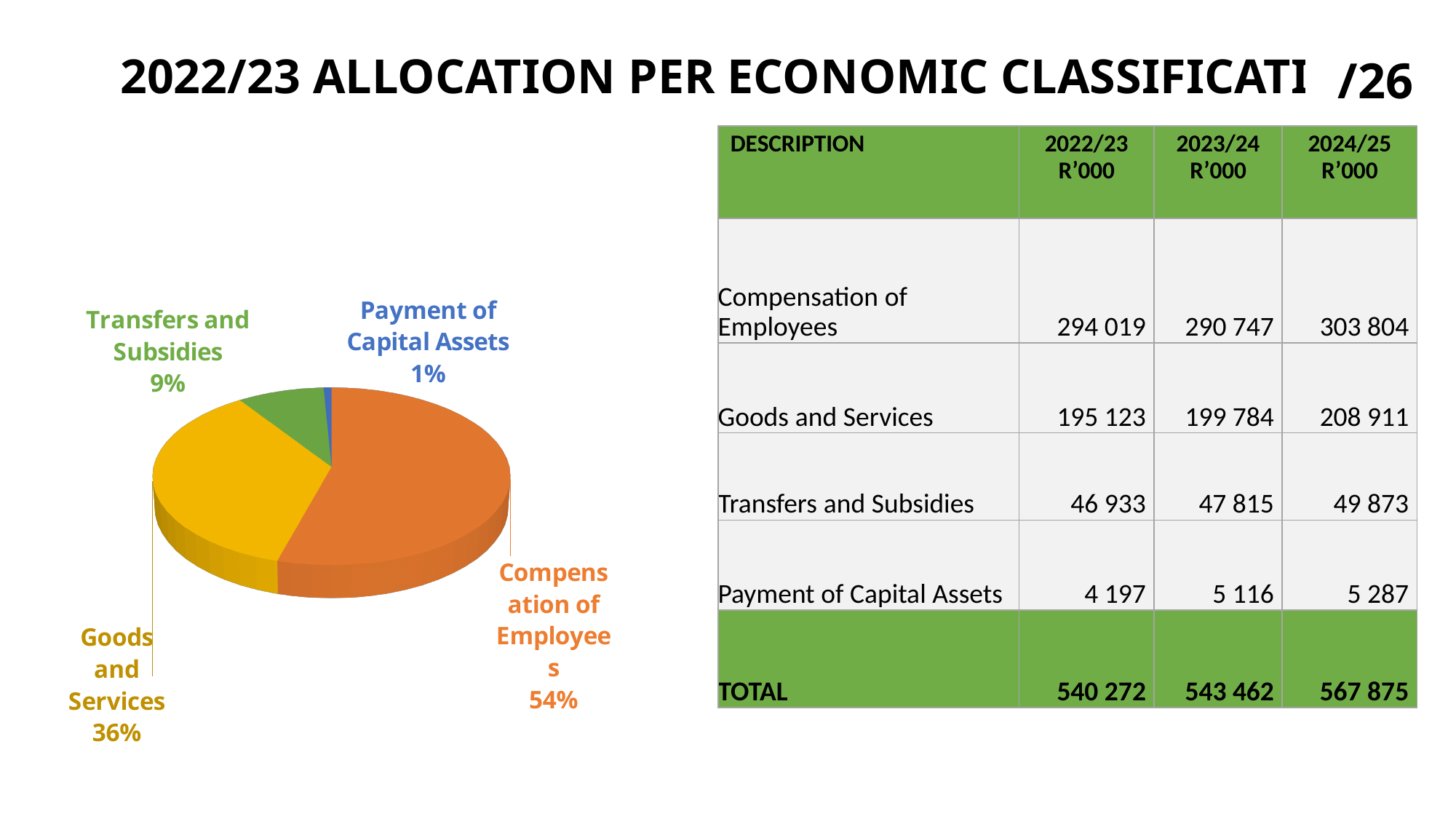
What colour is the Goods and Services slice in the pie chart? Yellow What kind of chart is shown on the left of the slide? Pie chart Which category has the largest slice in the pie chart? Compensation of Employees Which category has the smallest slice in the pie chart? Payment of Capital Assets What share of the pie chart does Payment of Capital Assets represent? 1% In the pie chart, what is the difference in percentage points between Compensation of Employees and Goods and Services? 18 What share of the pie chart does Goods and Services represent? 36% In the pie chart, which is larger: Transfers and Subsidies or Payment of Capital Assets? Transfers and Subsidies What share of the pie chart does Transfers and Subsidies represent? 9% In the pie chart, what is the difference in percentage points between Goods and Services and Transfers and Subsidies? 27 How many slices does the pie chart have? 4